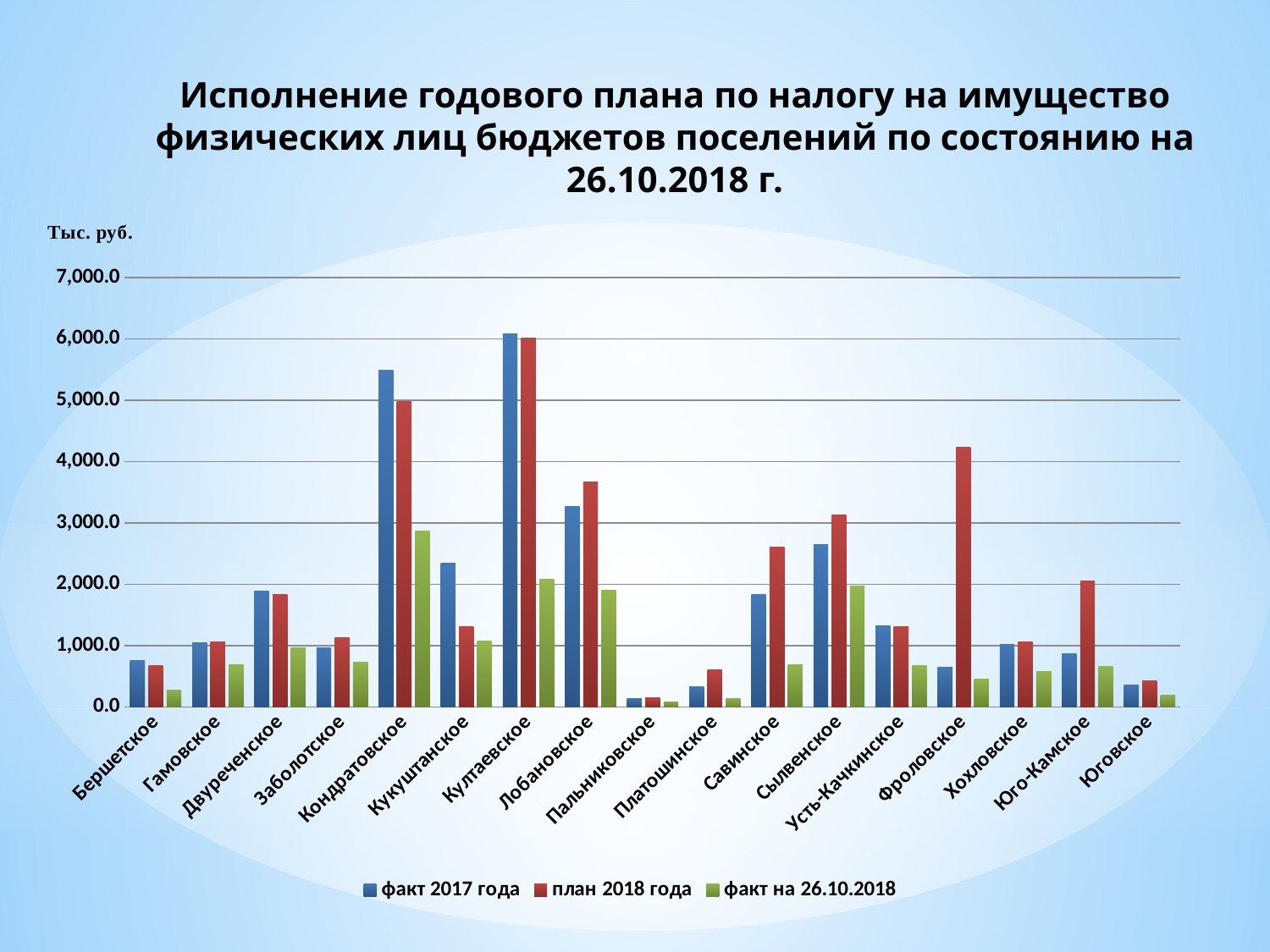
How many settlements (categories) are shown on the x axis? 17 What kind of chart is shown on the slide? bar chart Which settlement has the highest value for факт на 26.10.2018? Кондратовское Is the факт 2017 года value for Фроловское greater or less than 1,000.0? less For Лобановское, which is larger: факт 2017 года or план 2018 года? план 2018 года Is the факт 2017 года value for Кондратовское greater or less than 5,000.0? greater What unit is indicated above the vertical axis? Тыс. руб. How many series does the legend list? 3 Is the план 2018 года value for Фроловское greater or less than 4,000.0? greater For Кондратовское, which is larger: факт 2017 года or план 2018 года? факт 2017 года Which settlement has the highest value for факт 2017 года? Култаевское Which settlement has the lowest value for план 2018 года? Пальниковское